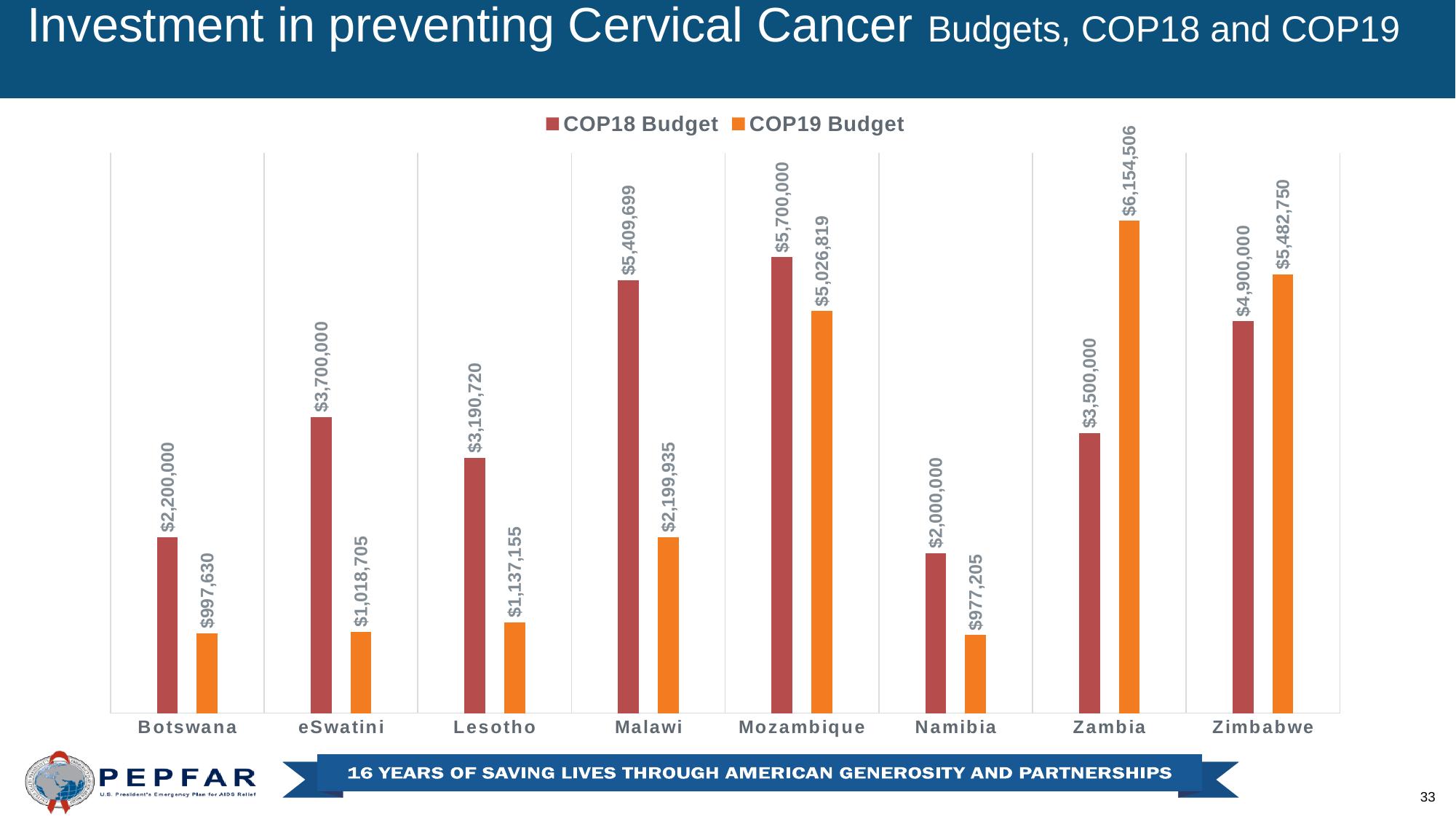
What is the COP18 Budget for Malawi? $5,409,699 How much larger is Zimbabwe's COP19 Budget than its COP18 Budget? $582,750 How many countries are shown on the x axis? 8 What kind of chart is shown on the slide? Bar chart What is the COP19 Budget for Zambia? $6,154,506 For Zambia, which is larger: the COP18 Budget or the COP19 Budget? COP19 Budget How many series does the legend list? 2 What is the COP19 Budget for Lesotho? $1,137,155 What is the difference between Mozambique's COP18 Budget and COP19 Budget? $673,181 Which country has the lowest COP19 Budget? Namibia Which country has the highest COP18 Budget? Mozambique Which country has the highest COP19 Budget? Zambia